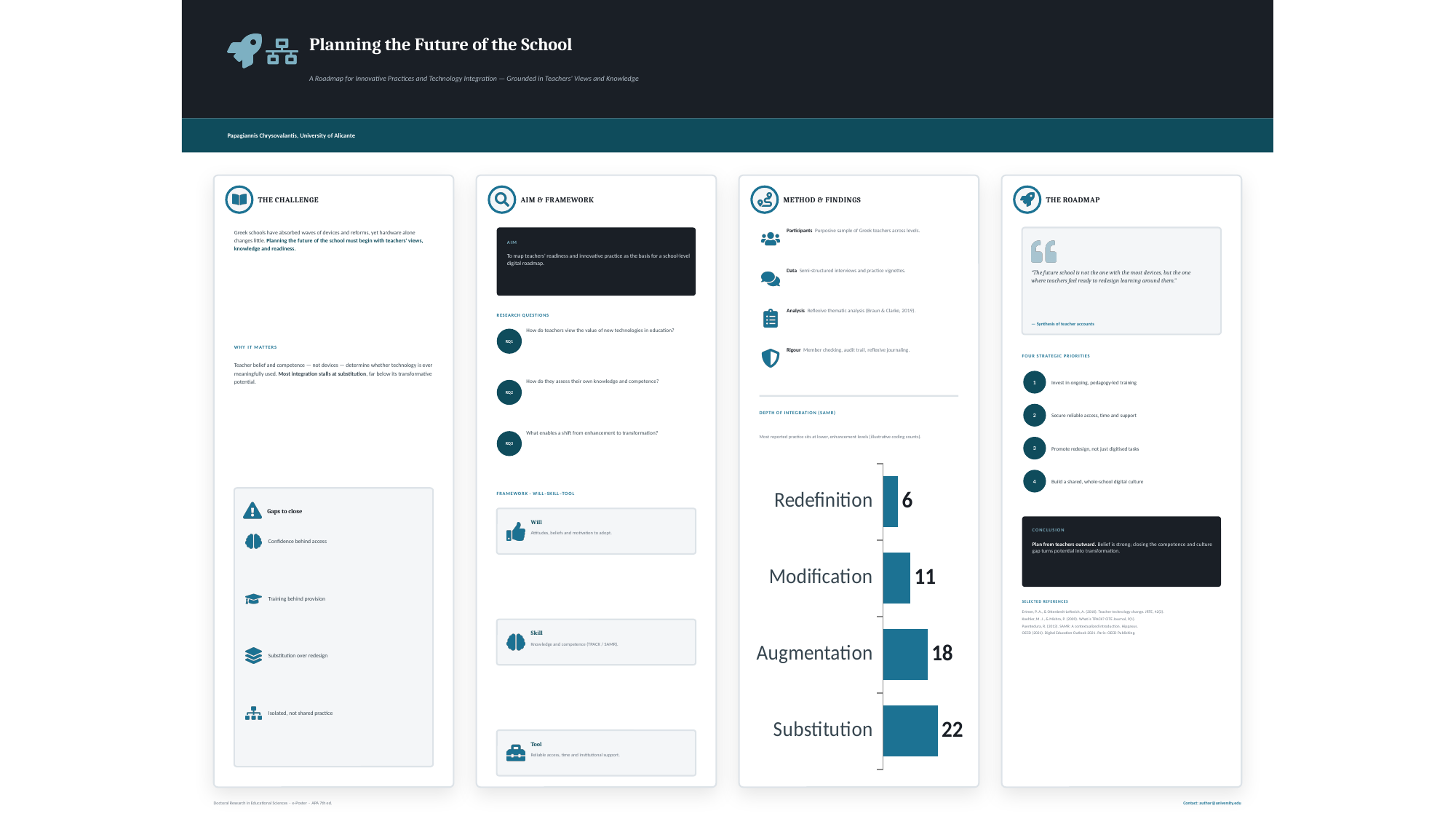
What is the difference between the values for Augmentation and Modification in the Depth of Integration (SAMR) chart? 7 How many categories are shown in the Depth of Integration (SAMR) chart? 4 In the Depth of Integration (SAMR) chart, which is larger: Modification or Augmentation? Augmentation What is the value for Modification in the Depth of Integration (SAMR) chart? 11 Which category has the highest value in the Depth of Integration (SAMR) chart? Substitution What is the value for Augmentation in the Depth of Integration (SAMR) chart? 18 What is the total of all four values in the Depth of Integration (SAMR) chart? 57 What is the value for Substitution in the Depth of Integration (SAMR) chart? 22 Which category has the lowest value in the Depth of Integration (SAMR) chart? Redefinition What is the value for Redefinition in the Depth of Integration (SAMR) chart? 6 What is the difference between the values for Substitution and Redefinition in the Depth of Integration (SAMR) chart? 16 What kind of chart is the Depth of Integration (SAMR) chart? Bar chart